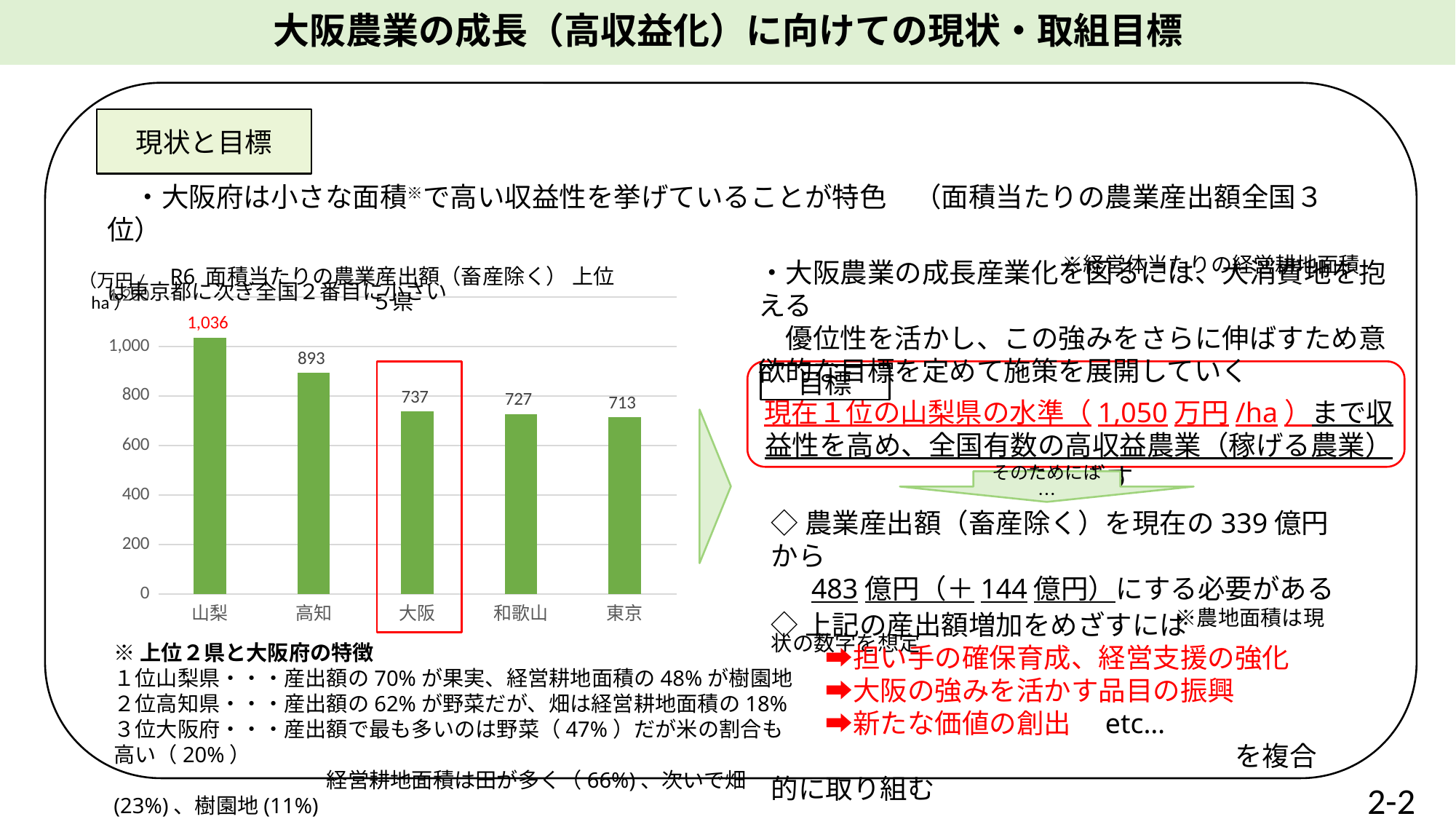
What is the difference between the values for 山梨 and 大阪 in the bar chart? 299 How many prefectures are shown in the bar chart? 5 What is the value for 和歌山 in the bar chart? 727 Which prefecture has the lowest value in the bar chart? 東京 Which prefecture has the highest value in the bar chart? 山梨 What is the value for 大阪 in the bar chart? 737 What is the value for 東京 in the bar chart? 713 What is the difference between the values for 高知 and 東京 in the bar chart? 180 What is the value for 山梨 in the bar chart? 1,036 What type of chart is shown on the slide? bar chart What is the value for 高知 in the bar chart? 893 Which is larger in the bar chart, the value for 高知 or the value for 大阪? 高知